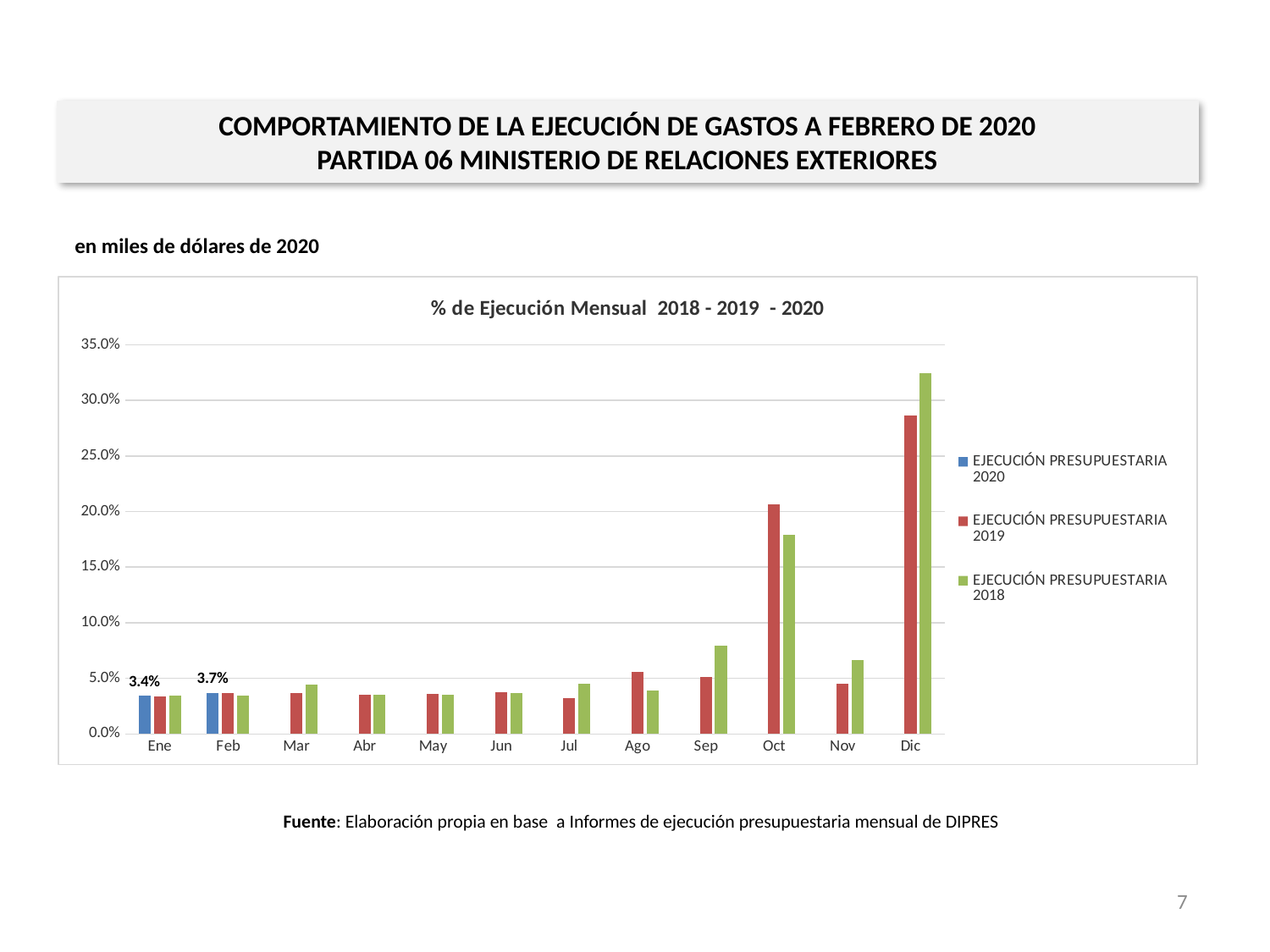
In Oct, which series has the larger value, EJECUCIÓN PRESUPUESTARIA 2019 or EJECUCIÓN PRESUPUESTARIA 2018? EJECUCIÓN PRESUPUESTARIA 2019 How many months are shown on the x axis of the chart? 12 Which month has the highest value for EJECUCIÓN PRESUPUESTARIA 2019? Dic Is the value for EJECUCIÓN PRESUPUESTARIA 2019 in Dic greater or less than 30.0%? less Is the value for EJECUCIÓN PRESUPUESTARIA 2018 in Dic greater or less than 30.0%? greater What is the difference between the 2020 values for Feb and Ene? 0.3% What type of chart is shown on the slide? Bar chart What is the value for EJECUCIÓN PRESUPUESTARIA 2020 in Ene? 3.4% For EJECUCIÓN PRESUPUESTARIA 2020, which month has the larger value, Ene or Feb? Feb How many series does the chart legend list? 3 Which month has the highest value for EJECUCIÓN PRESUPUESTARIA 2018? Dic What is the value for EJECUCIÓN PRESUPUESTARIA 2020 in Feb? 3.7%